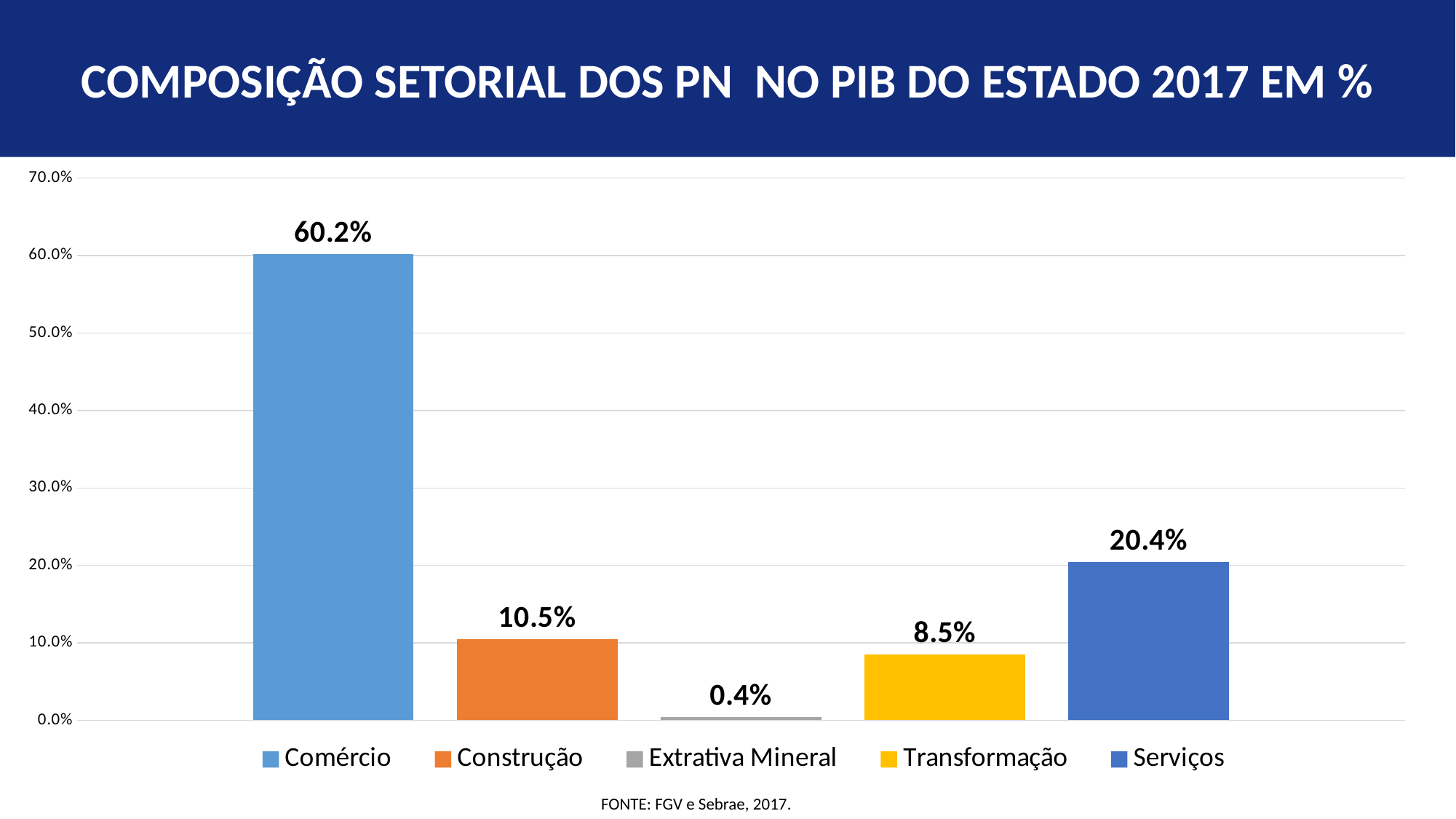
What is the value for Transformação? 8.5% How many sectors are shown in the chart? 5 Which sector has the lowest value? Extrativa Mineral What is the value for Serviços? 20.4% What is the difference between the values for Comércio and Serviços? 39.8% Which is larger, the value for Construção or the value for Transformação? Construção What kind of chart is shown on the slide? Bar chart Is the value for Serviços greater or less than 30.0%? less What is the value for Construção? 10.5% What is the value for Extrativa Mineral? 0.4% Which sector has the highest value? Comércio What is the value for Comércio? 60.2%